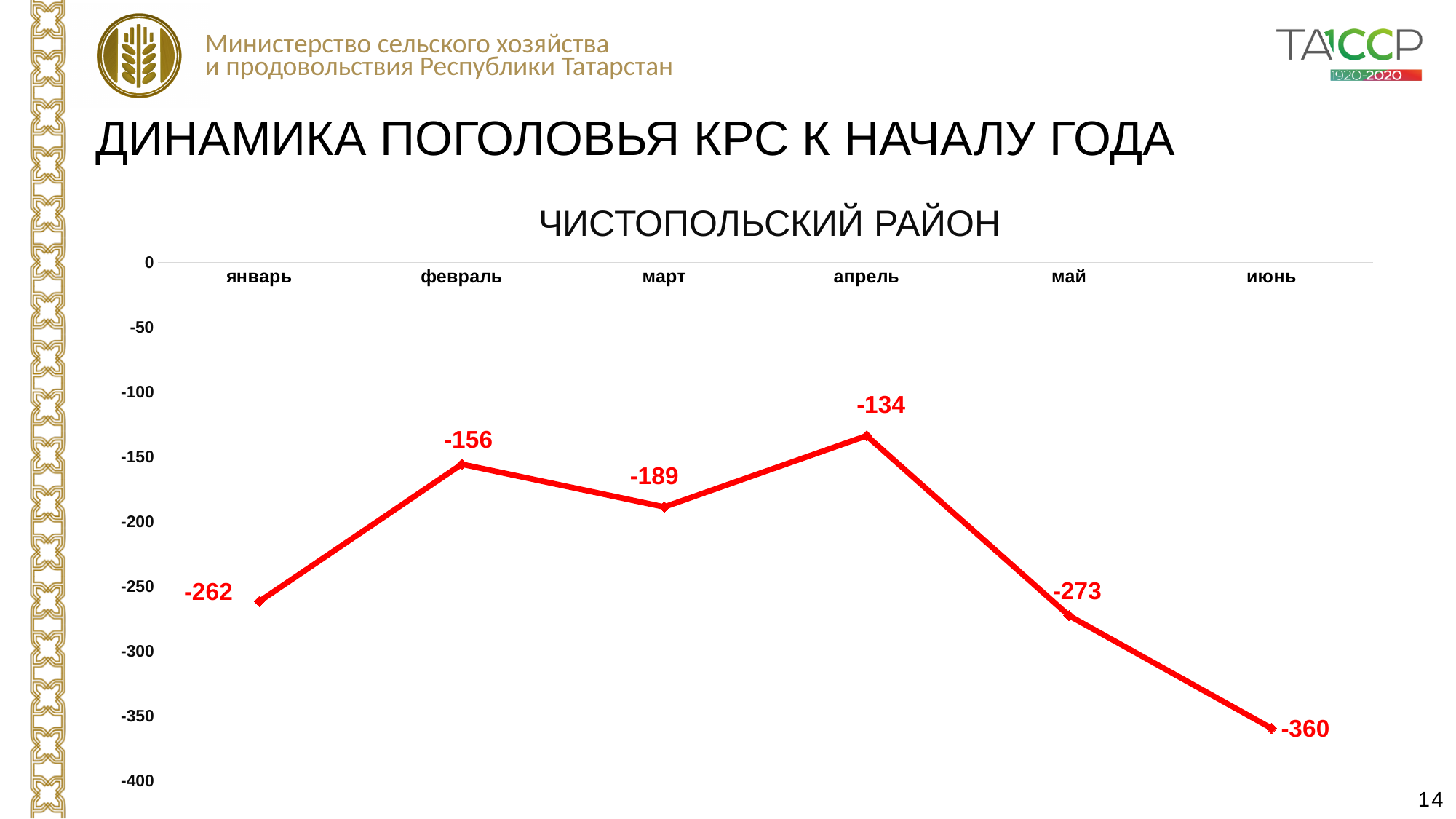
What is the difference between the values for февраль and март? 33 Which month has the lowest value? июнь Which is larger, the value for февраль or the value for май? февраль What is the title of the chart? ЧИСТОПОЛЬСКИЙ РАЙОН What is the difference between the values for май and июнь? 87 What is the value for январь? -262 How many months are plotted on the chart? 6 What is the value for март? -189 What is the value for апрель? -134 What is the value for июнь? -360 What kind of chart is shown? line chart Which month has the highest value? апрель